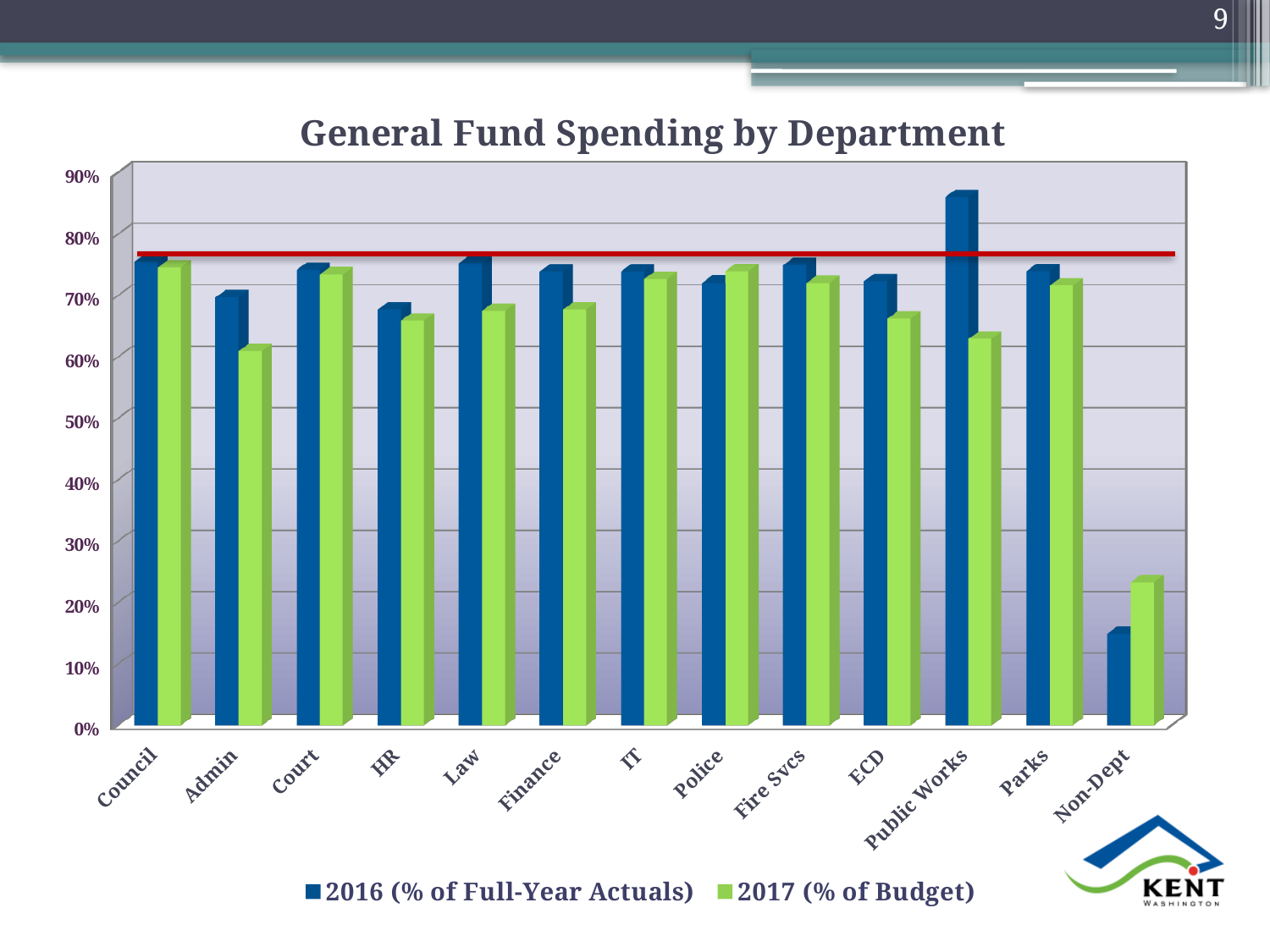
For Public Works, which is larger: the 2016 (% of Full-Year Actuals) value or the 2017 (% of Budget) value? 2016 (% of Full-Year Actuals) How many series does the legend list? 2 Which department has the lowest value for 2016 (% of Full-Year Actuals)? Non-Dept Is the 2016 (% of Full-Year Actuals) value for Non-Dept greater or less than 20%? less What kind of chart is shown on the slide? bar chart Is the 2017 (% of Budget) value for Admin greater or less than 70%? less How many departments are shown on the x axis? 13 Which department has the lowest value for 2017 (% of Budget)? Non-Dept Is the 2016 (% of Full-Year Actuals) value for Public Works greater or less than 80%? greater What is the title of the chart? General Fund Spending by Department Which department has the highest value for 2016 (% of Full-Year Actuals)? Public Works For Non-Dept, which is larger: the 2016 (% of Full-Year Actuals) value or the 2017 (% of Budget) value? 2017 (% of Budget)